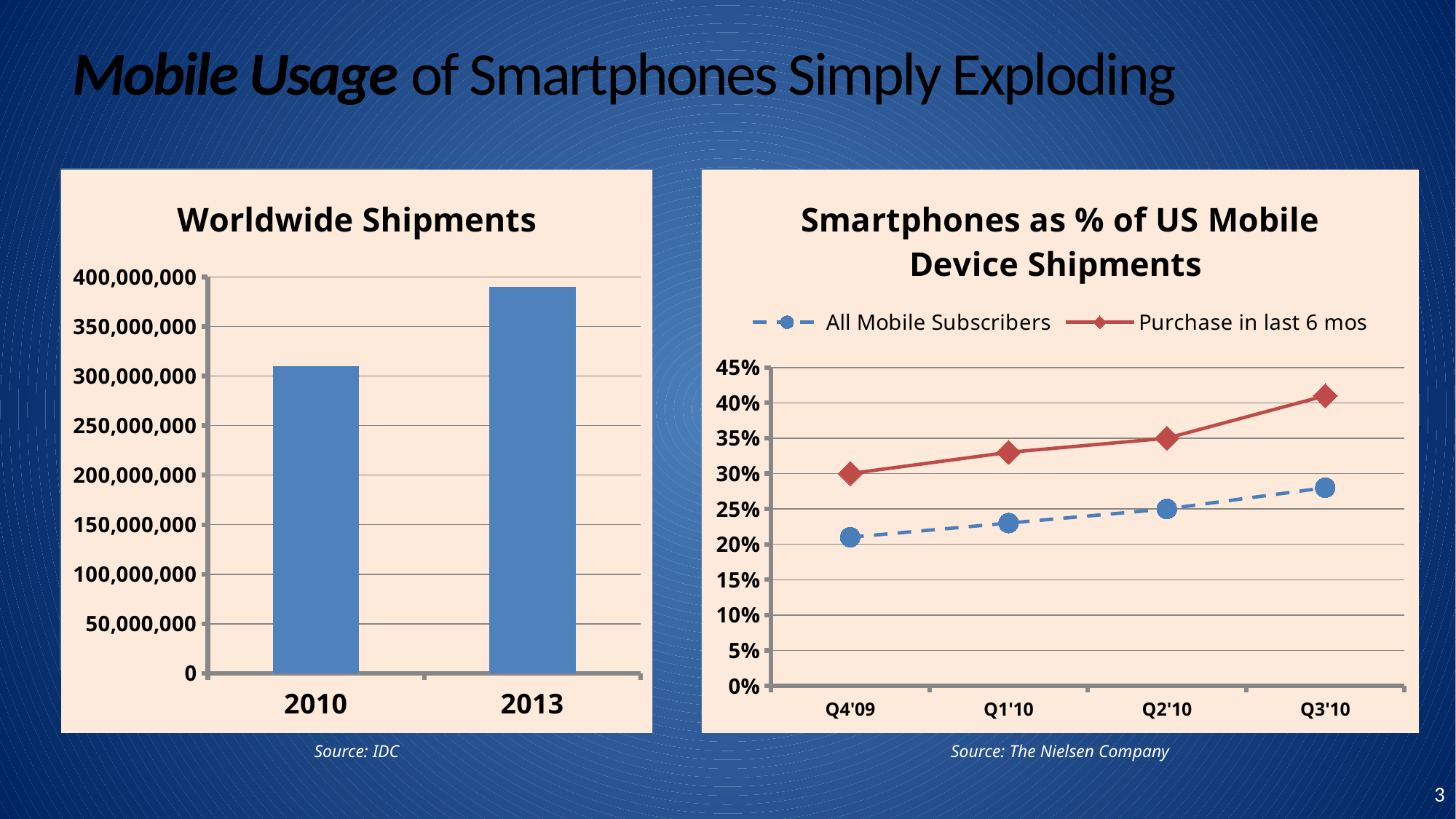
In the Worldwide Shipments chart, is the value for 2013 greater or less than 400,000,000? less How many series does the legend of the Smartphones as % of US Mobile Device Shipments chart list? 2 In the Smartphones as % of US Mobile Device Shipments chart, which series is drawn with a dashed line? All Mobile Subscribers In the Worldwide Shipments chart, is the value for 2010 greater or less than 300,000,000? greater In the Smartphones as % of US Mobile Device Shipments chart, which series is higher at Q1'10, All Mobile Subscribers or Purchase in last 6 mos? Purchase in last 6 mos What kind of chart is the Smartphones as % of US Mobile Device Shipments chart? line chart In the Worldwide Shipments chart, how many years are shown on the x axis? 2 What kind of chart is the Worldwide Shipments chart? bar chart In the Worldwide Shipments chart, which year has the higher value? 2013 In the Smartphones as % of US Mobile Device Shipments chart, do the values for Purchase in last 6 mos rise or fall from Q4'09 to Q3'10? rise In the Smartphones as % of US Mobile Device Shipments chart, how many quarters are shown on the x axis? 4